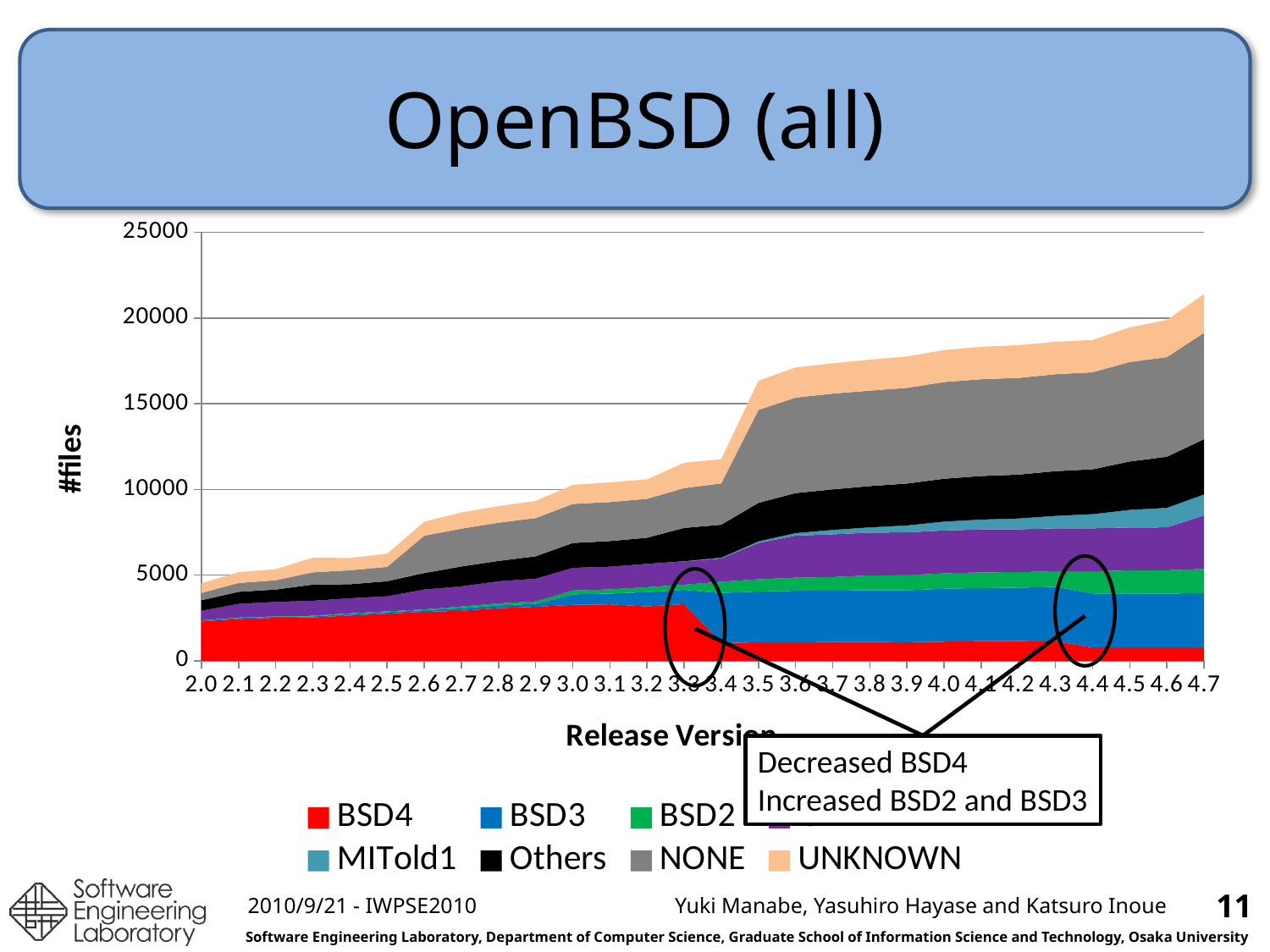
Does the total number of files generally rise or fall from release 2.0 to release 4.7? rise What kind of chart is shown on the slide? Stacked area chart What colour represents the BSD4 series? Red Is the total number of files at release 3.5 greater or less than 15000? greater Is the total number of files larger at release 3.5 or at release 3.4? 3.5 What is the label of the y axis? #files Which release version has the lowest total number of files? 2.0 Which release version has the highest total number of files? 4.7 Is the total number of files at release 2.0 greater or less than 5000? less Is the total number of files at release 4.7 greater or less than 20000? greater How many release versions are shown along the x axis? 28